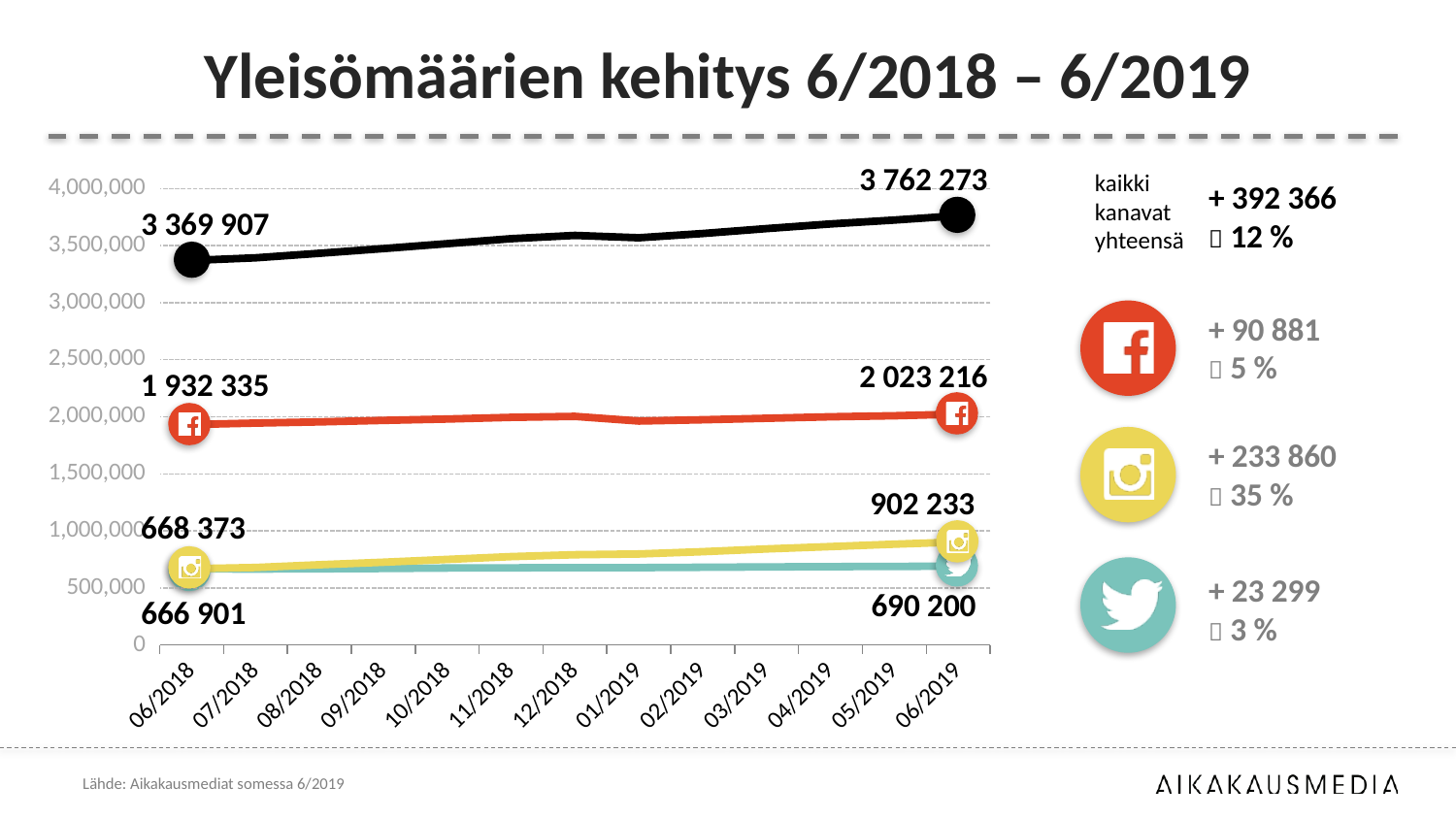
What is the Facebook value at 06/2019? 2 023 216 Is the Facebook value at 06/2018 greater or less than 1,500,000? greater By how much did the Facebook value increase from 06/2018 to 06/2019? 90 881 By how much did the Instagram value increase from 06/2018 to 06/2019? 233 860 What is the value of the black (all channels total) line at 06/2019? 3 762 273 What is the Twitter value at 06/2019? 690 200 Which is larger at 06/2019, the Instagram value or the Twitter value? Instagram What is the Instagram value at 06/2018? 668 373 Does the black (all channels total) line rise or fall from 06/2018 to 06/2019? rise What is the value of the black (all channels total) line at 06/2018? 3 369 907 What kind of chart is shown on the slide? line chart How many months are shown on the x axis? 13